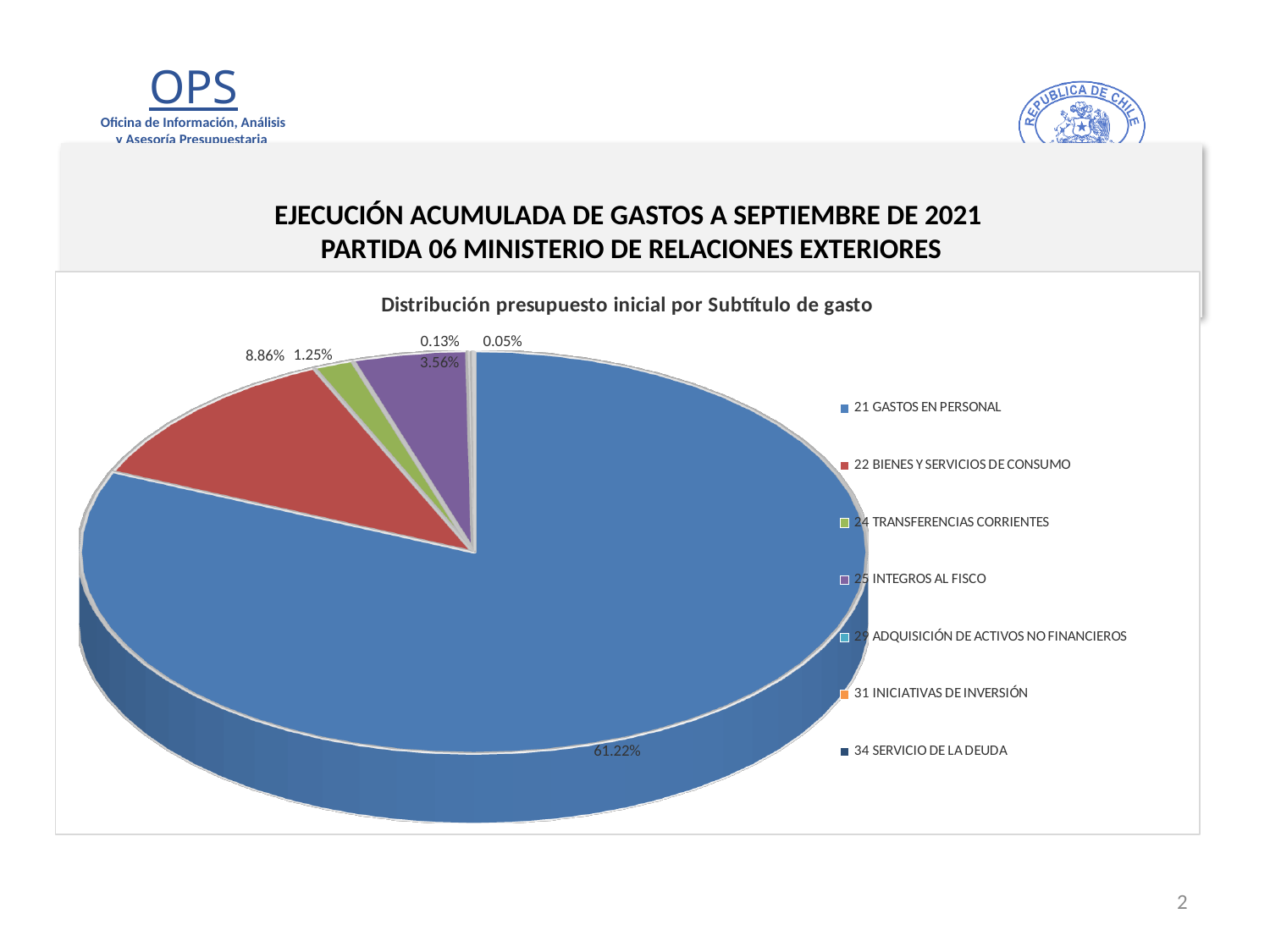
Which category has the largest slice of the pie? 21 GASTOS EN PERSONAL What is the difference in percentage points between 21 GASTOS EN PERSONAL and 22 BIENES Y SERVICIOS DE CONSUMO? 52.36% How many categories does the chart legend list? 7 What is the title of the chart? Distribución presupuesto inicial por Subtítulo de gasto What kind of chart is shown on the slide? pie chart What colour is the slice for 21 GASTOS EN PERSONAL? blue What share of the pie does 25 INTEGROS AL FISCO represent? 3.56% What is the difference in percentage points between 25 INTEGROS AL FISCO and 24 TRANSFERENCIAS CORRIENTES? 2.31% What share of the pie does 21 GASTOS EN PERSONAL represent? 61.22% What share of the pie does 24 TRANSFERENCIAS CORRIENTES represent? 1.25% Which is larger, the share for 22 BIENES Y SERVICIOS DE CONSUMO or for 25 INTEGROS AL FISCO? 22 BIENES Y SERVICIOS DE CONSUMO